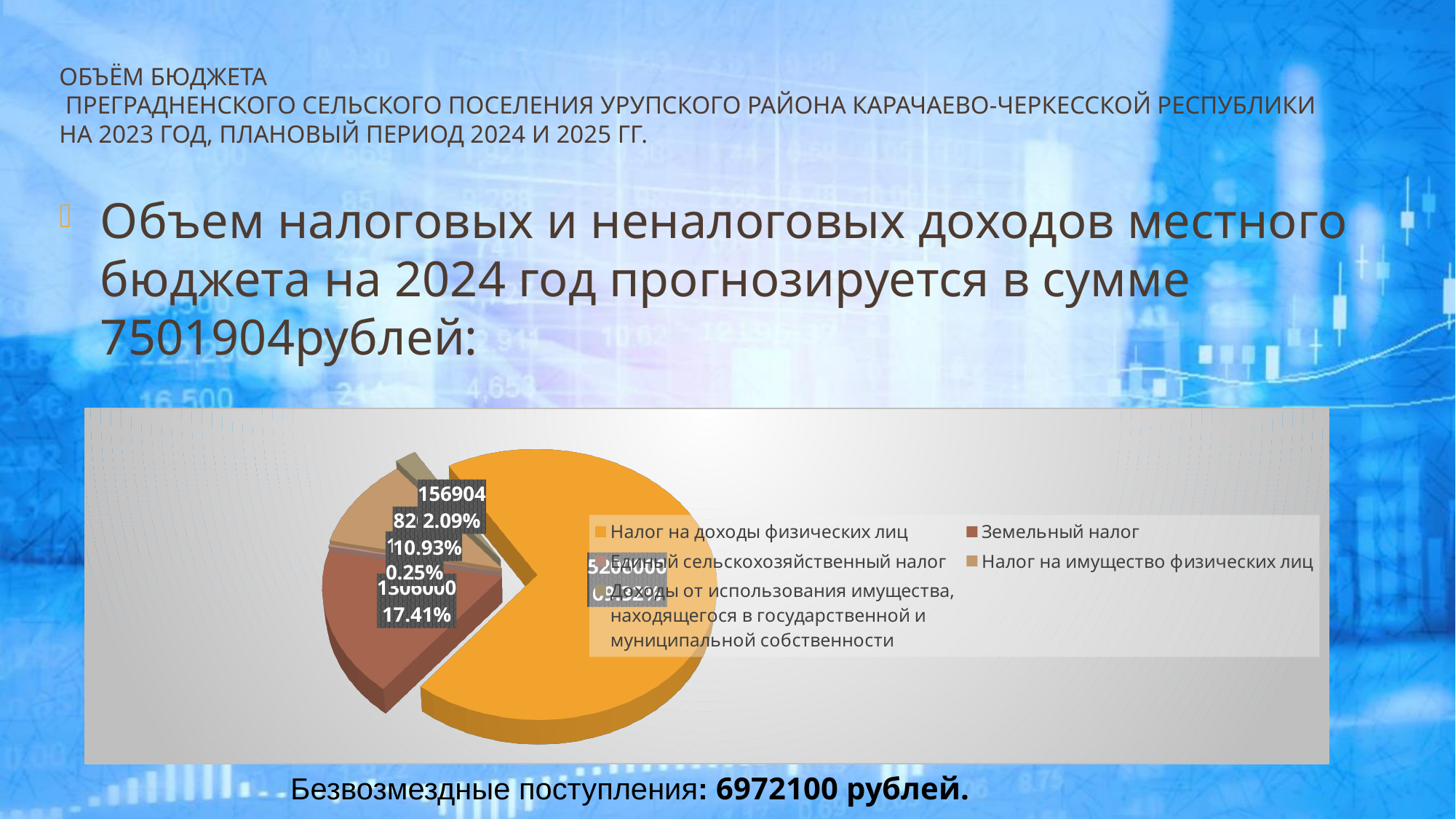
What colour is the slice for Налог на доходы физических лиц? orange Is the share of Налог на доходы физических лиц greater or less than 50%? greater Which legend entry is listed first in the pie chart's legend? Налог на доходы физических лиц What share of the pie does Земельный налог have? 17.41% What kind of chart is shown on the slide? pie chart Which category has the largest slice in the pie chart? Налог на доходы физических лиц Which slice is larger: Земельный налог or Налог на имущество физических лиц? Земельный налог How many entries does the legend of the pie chart list? 5 How many categories are shown in the pie chart? 5